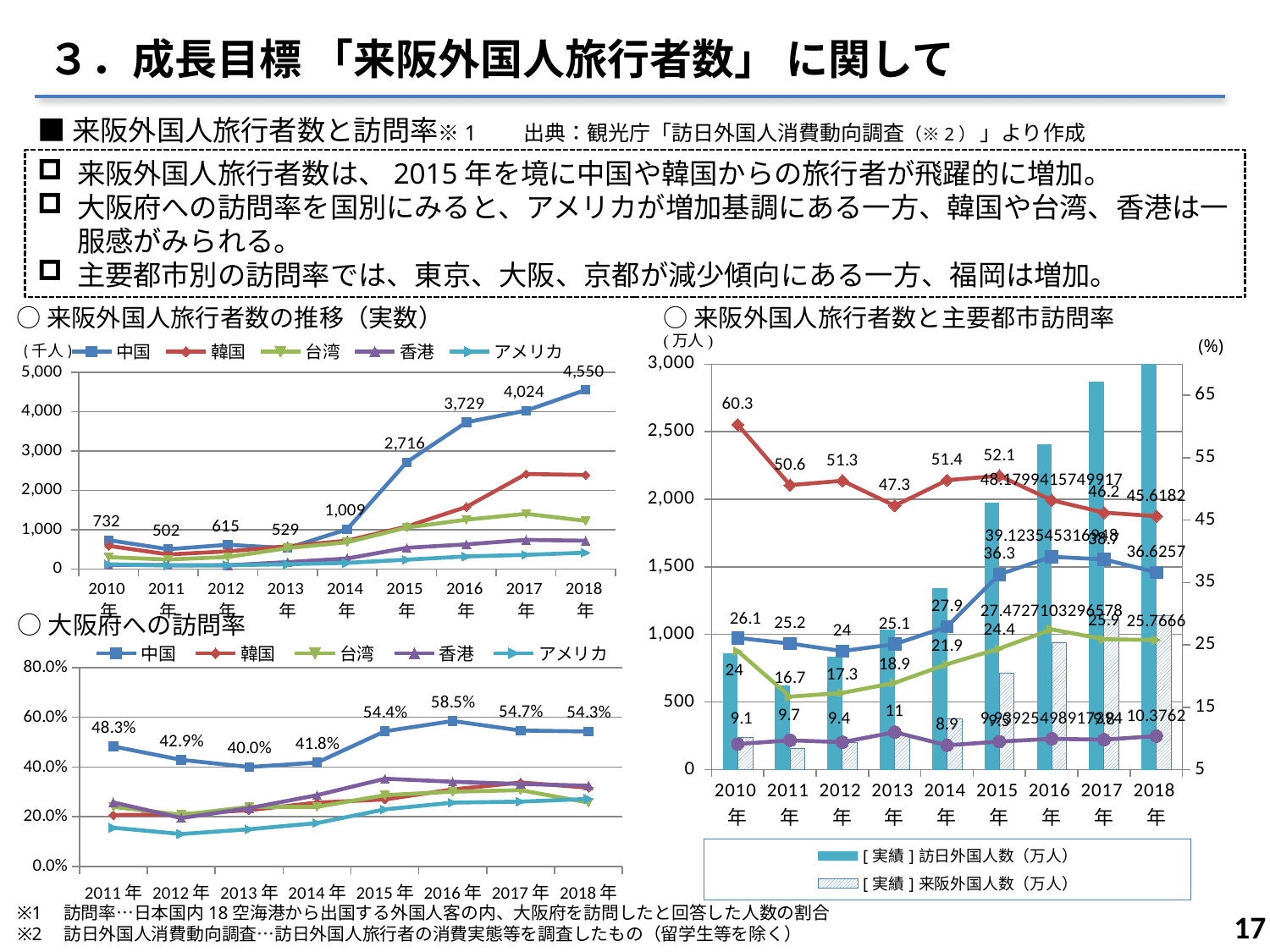
What kind of chart is the chart titled 来阪外国人旅行者数の推移（実数）? line chart In the chart titled 大阪府への訪問率, in which year is the 中国 value highest? 2016年 In the chart titled 来阪外国人旅行者数の推移（実数）, does the 中国 line rise or fall from 2013年 to 2018年? rise In the chart titled 来阪外国人旅行者数の推移（実数）, what is the value for 中国 in 2018年? 4,550 In the chart titled 来阪外国人旅行者数の推移（実数）, how many series does the legend list? 5 In the chart titled 大阪府への訪問率, how many years are shown on the x axis? 8 In the chart titled 来阪外国人旅行者数の推移（実数）, what is the difference between the 中国 values for 2018年 and 2017年? 526 In the chart titled 来阪外国人旅行者数の推移（実数）, in which year is the 中国 value lowest? 2011年 In the chart titled 来阪外国人旅行者数と主要都市訪問率, is the [実績]訪日外国人数（万人） bar for 2018年 greater or less than 2,500? greater In the chart titled 来阪外国人旅行者数の推移（実数）, what is the value for 中国 in 2015年? 2,716 In the chart titled 大阪府への訪問率, what is the value for 中国 in 2016年? 58.5% In the chart titled 大阪府への訪問率, what is the difference between the 中国 values for 2016年 and 2015年? 4.1%